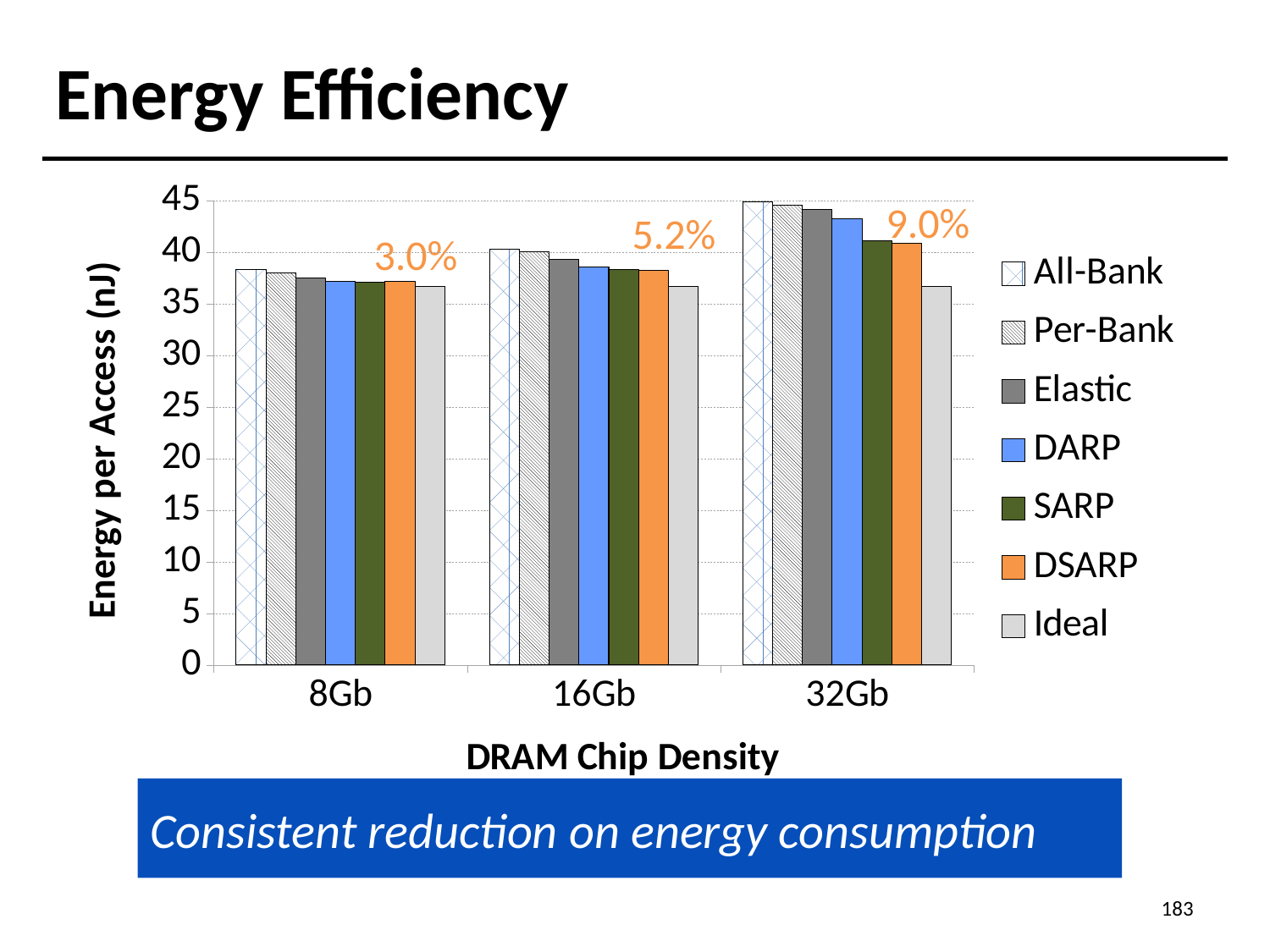
What kind of chart is shown on the slide? bar chart What percentage is annotated above the 32Gb group? 9.0% Does the All-Bank energy per access rise or fall as DRAM chip density increases from 8Gb to 32Gb? rises Is the All-Bank value for 32Gb greater or less than 40? greater How many DRAM chip density categories are shown on the x axis? 3 How many series does the legend list? 7 Within the 32Gb group, which series has the lowest energy per access? Ideal Is the Ideal value for 16Gb greater or less than 40? less At 32Gb, which is larger: the All-Bank value or the Ideal value? All-Bank Is the DARP value for 32Gb greater or less than 40? greater For which DRAM chip density is the All-Bank energy per access highest? 32Gb